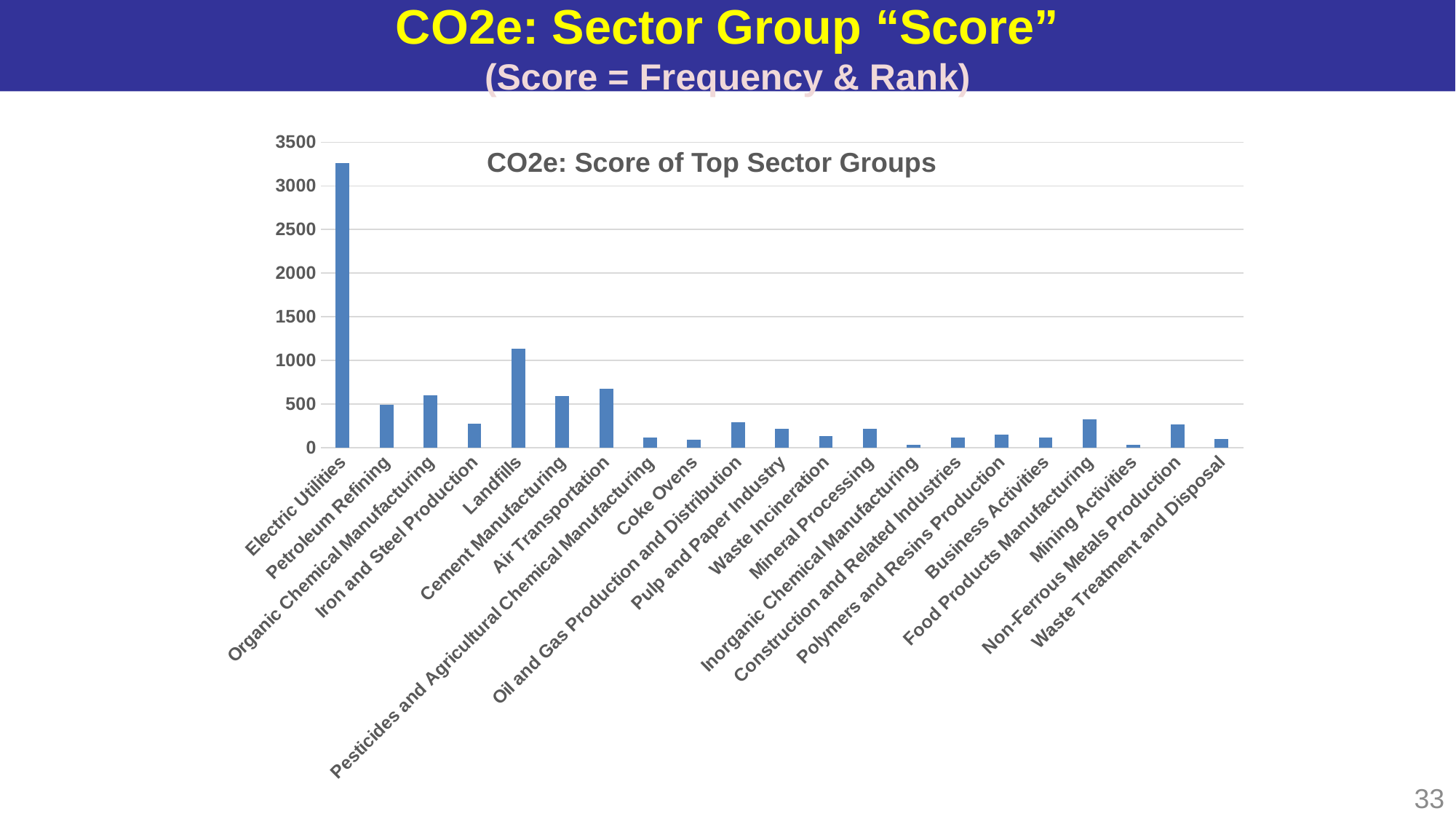
What kind of chart is shown on the slide? bar chart Which has a higher score, Coke Ovens or Oil and Gas Production and Distribution? Oil and Gas Production and Distribution How many sector groups are plotted on the chart? 21 Is the score for Landfills greater or less than 1000? greater Is the score for Electric Utilities greater or less than 3000? greater Which has a higher score, Petroleum Refining or Iron and Steel Production? Petroleum Refining Is the score for Air Transportation greater or less than 500? greater What is the title of the chart? CO2e: Score of Top Sector Groups Which has a higher score, Landfills or Air Transportation? Landfills Which sector group has the highest score? Electric Utilities